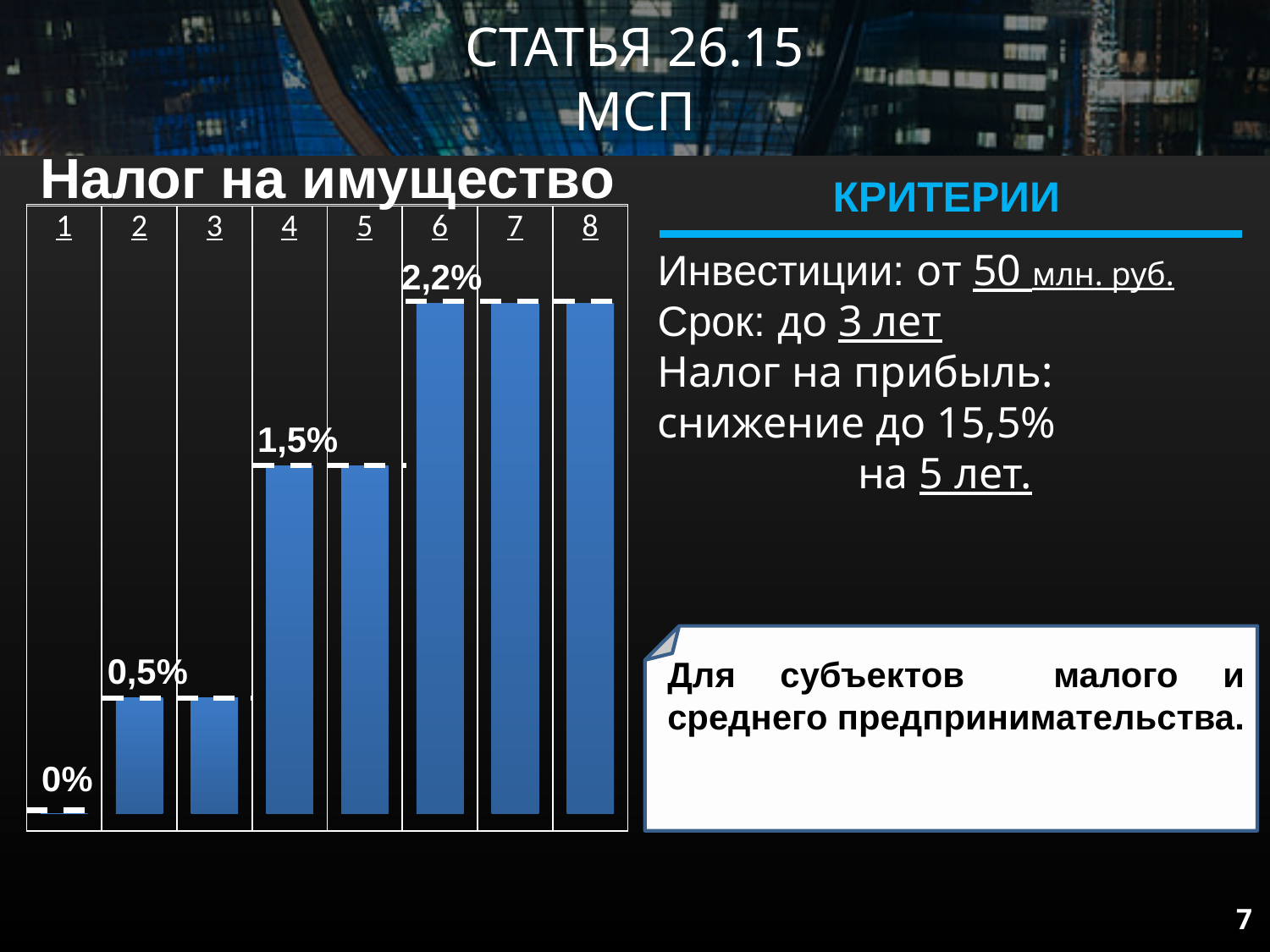
What is the difference between the value for category 6 and the value for category 4 in the Налог на имущество chart? 0,7% Which category has the lowest value in the Налог на имущество chart? 1 What is the value shown for category 1 in the Налог на имущество chart? 0% Do the values in the Налог на имущество chart rise or fall from category 1 to category 8? rise What is the value shown for category 2 in the Налог на имущество chart? 0,5% How many categories are shown along the x axis of the Налог на имущество chart? 8 What is the difference between the value for category 4 and the value for category 2 in the Налог на имущество chart? 1% What is the title of the chart on the slide? Налог на имущество Which is larger in the Налог на имущество chart: the value for category 4 or the value for category 2? category 4 What is the value shown for category 4 in the Налог на имущество chart? 1,5% What is the value shown for category 6 in the Налог на имущество chart? 2,2% What kind of chart is the Налог на имущество chart? bar chart